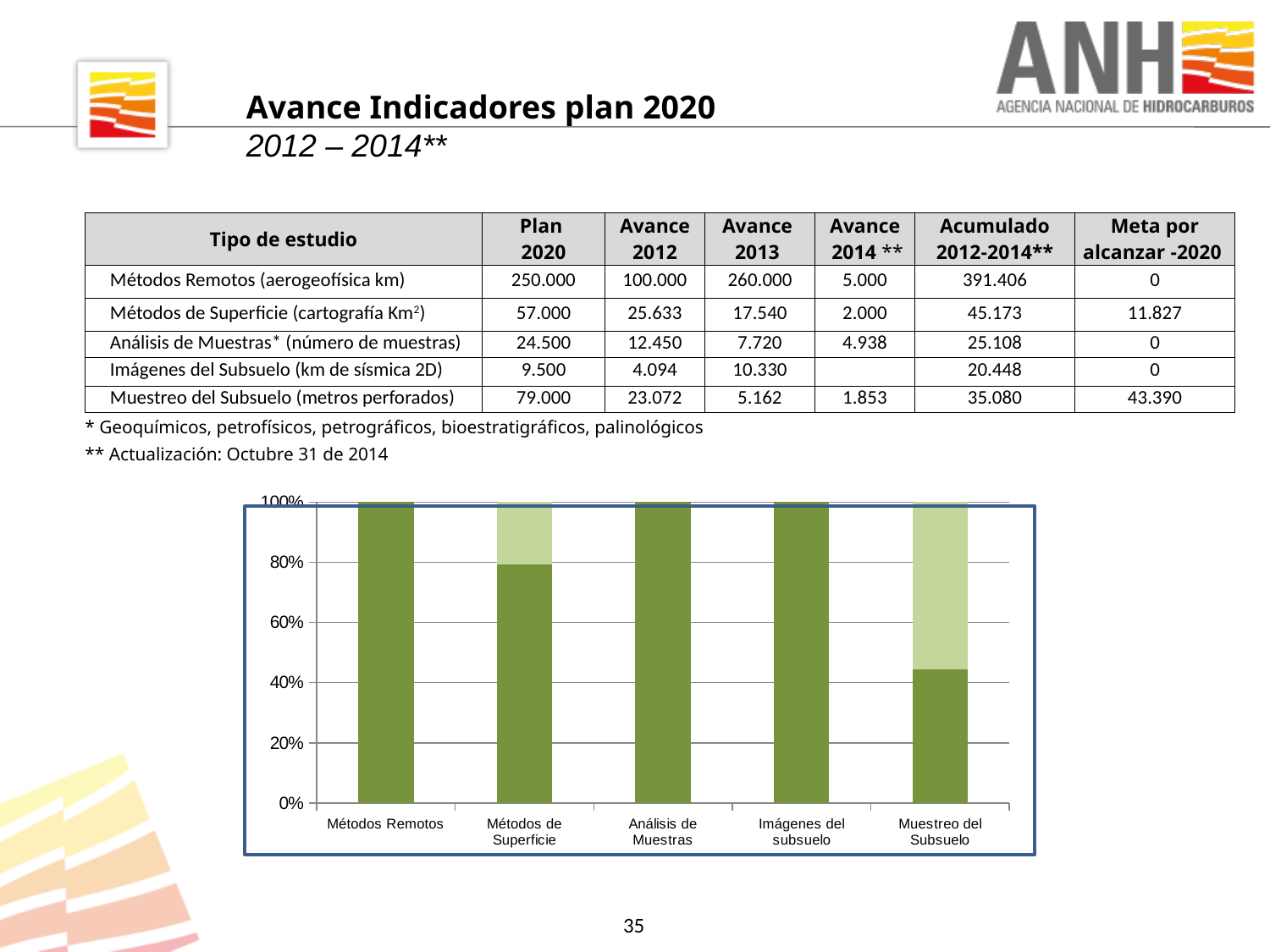
Is the dark green segment for Muestreo del Subsuelo greater or less than 20%? greater Is the dark green segment for Muestreo del Subsuelo greater or less than 60%? less Is the light green segment for Métodos de Superficie greater or less than 40%? less Which has the larger light green segment, Muestreo del Subsuelo or Métodos de Superficie? Muestreo del Subsuelo What is the label of the last category on the x axis of the chart? Muestreo del Subsuelo How many categories are shown on the x axis of the chart? 5 Which has the larger dark green segment, Métodos de Superficie or Muestreo del Subsuelo? Métodos de Superficie What is the highest value shown on the y axis of the chart? 100% Which category has the smallest dark green segment in the chart? Muestreo del Subsuelo What kind of chart is shown on the slide? stacked bar chart